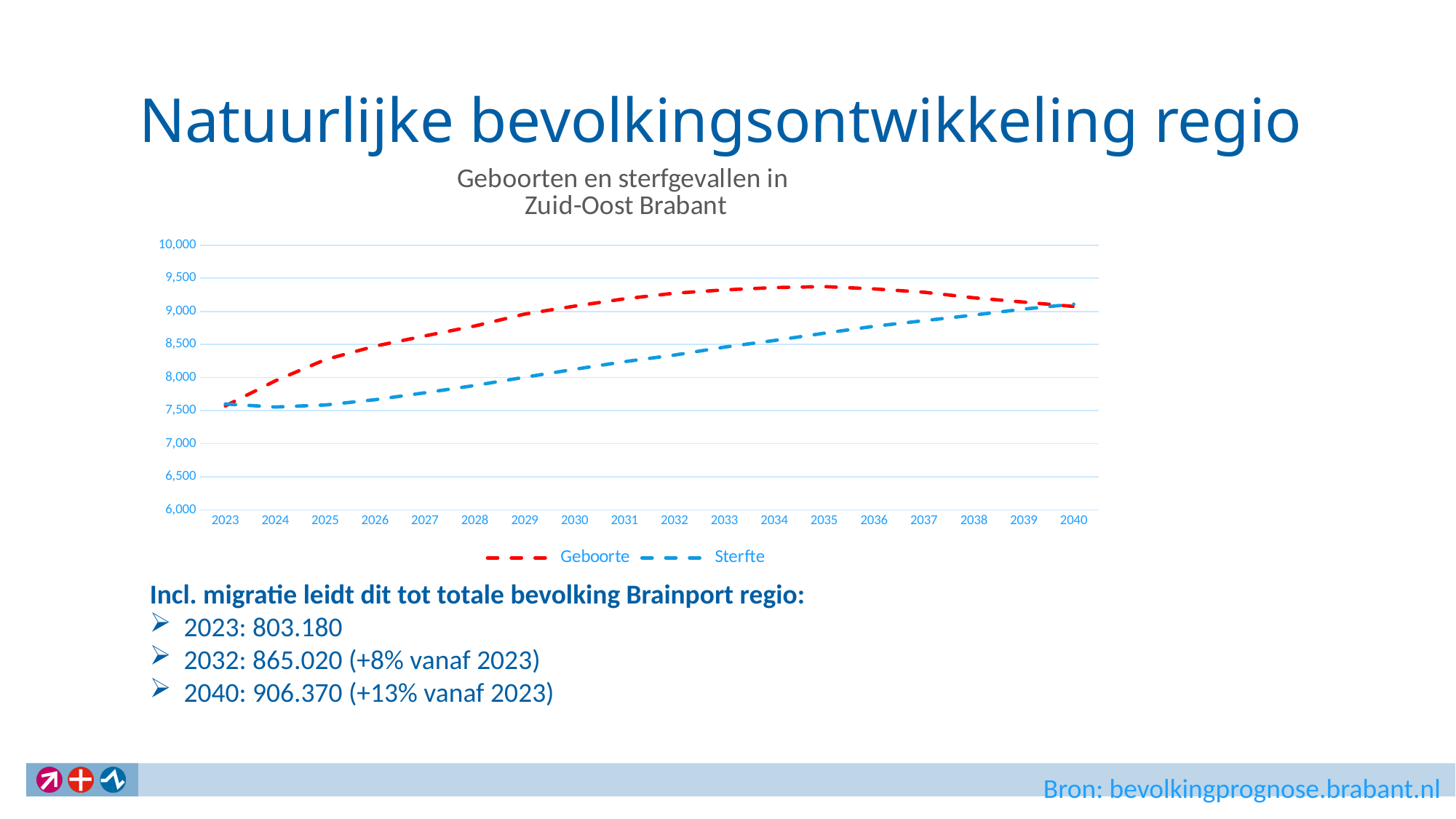
Is the value for Geboorte in 2027 greater or less than 8,000? greater Is the value for Geboorte in 2035 greater or less than 9,000? greater How many years are shown on the x axis of the chart? 18 How many series does the legend list? 2 Which series is drawn with the red dashed line? Geboorte Does the Sterfte line rise or fall from 2025 to 2040? rise Is the value for Sterfte in 2030 greater or less than 8,500? less What is the title of the chart? Geboorten en sterfgevallen in Zuid-Oost Brabant What kind of chart is shown on the slide? line chart In 2030, which series has the larger value, Geboorte or Sterfte? Geboorte